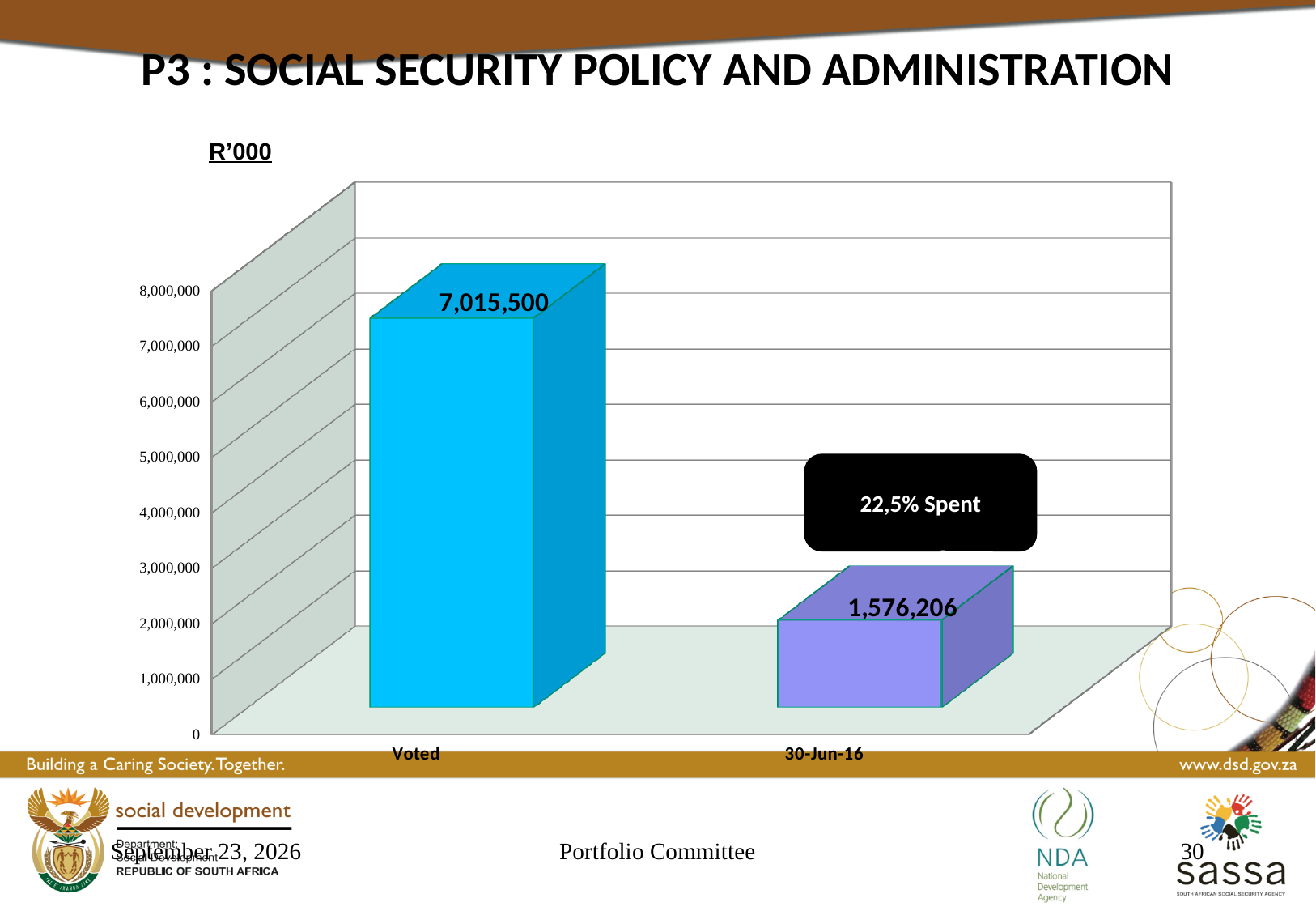
What is the value for Voted? 7,015,500 What is the difference between the Voted value and the 30-Jun-16 value? 5,439,294 What unit label is shown above the chart? R'000 What percentage spent is shown in the callout on the chart? 22,5% Spent What is the value for 30-Jun-16? 1,576,206 Is the value for Voted greater or less than 6,000,000? greater Is the value for 30-Jun-16 greater or less than 2,000,000? less What kind of chart is shown on the slide? bar chart How many categories are shown on the x axis? 2 Which category has the highest value? Voted Which category has the lowest value? 30-Jun-16 Which is larger, the value for Voted or the value for 30-Jun-16? Voted